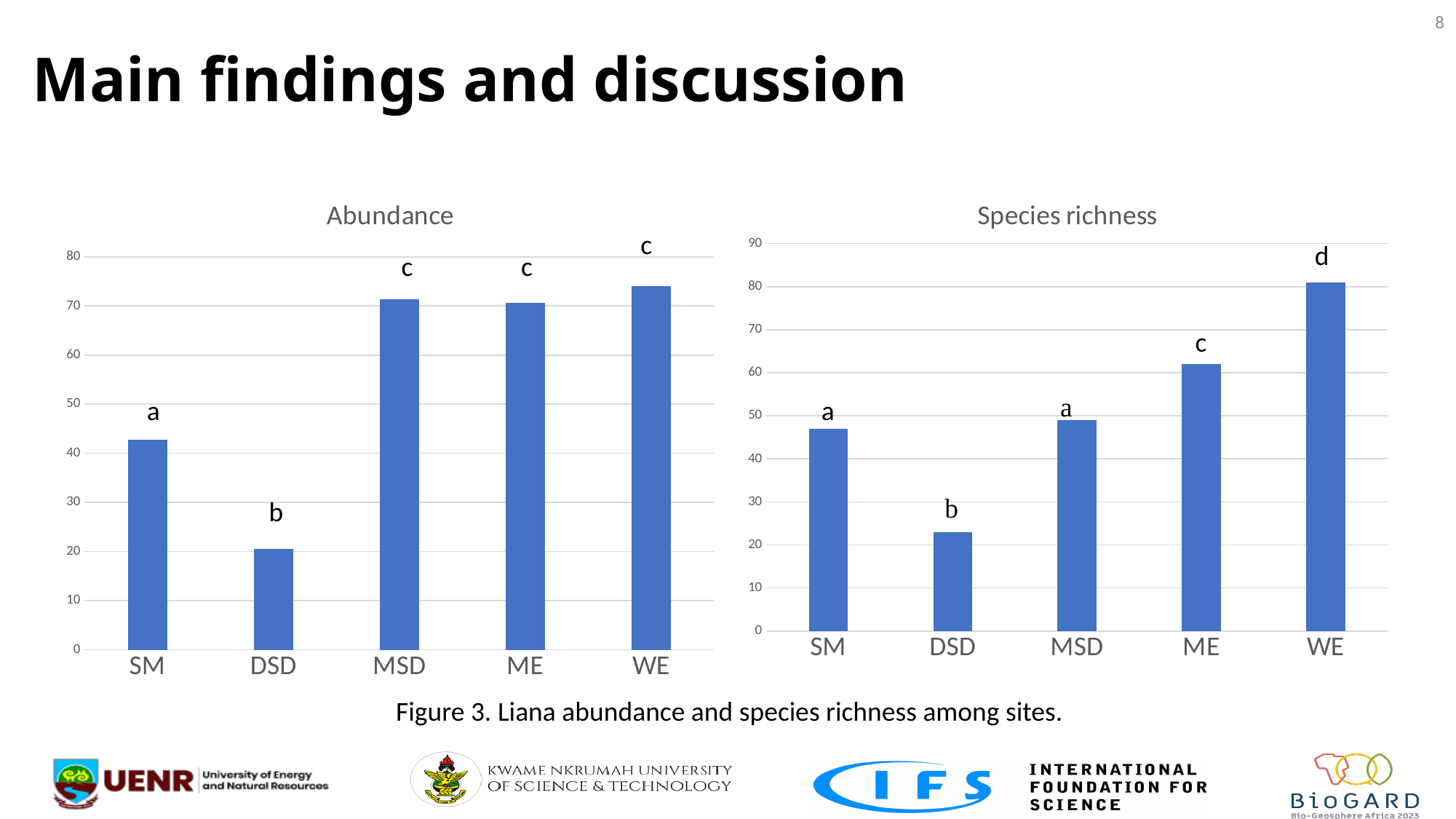
What kind of chart is the Abundance chart? bar chart In the Species richness chart, is the value for ME greater or less than 50? greater In the Species richness chart, which site has the lowest value? DSD In the Abundance chart, is the value for MSD greater or less than 60? greater How many sites are shown on the x axis of the Species richness chart? 5 In the Species richness chart, which site has the highest value? WE In the Abundance chart, is the value for SM greater or less than 40? greater In the Species richness chart, which is larger, the value for ME or the value for MSD? ME In the Species richness chart, what letter is printed above the WE bar? d In the Abundance chart, which site has the lowest value? DSD